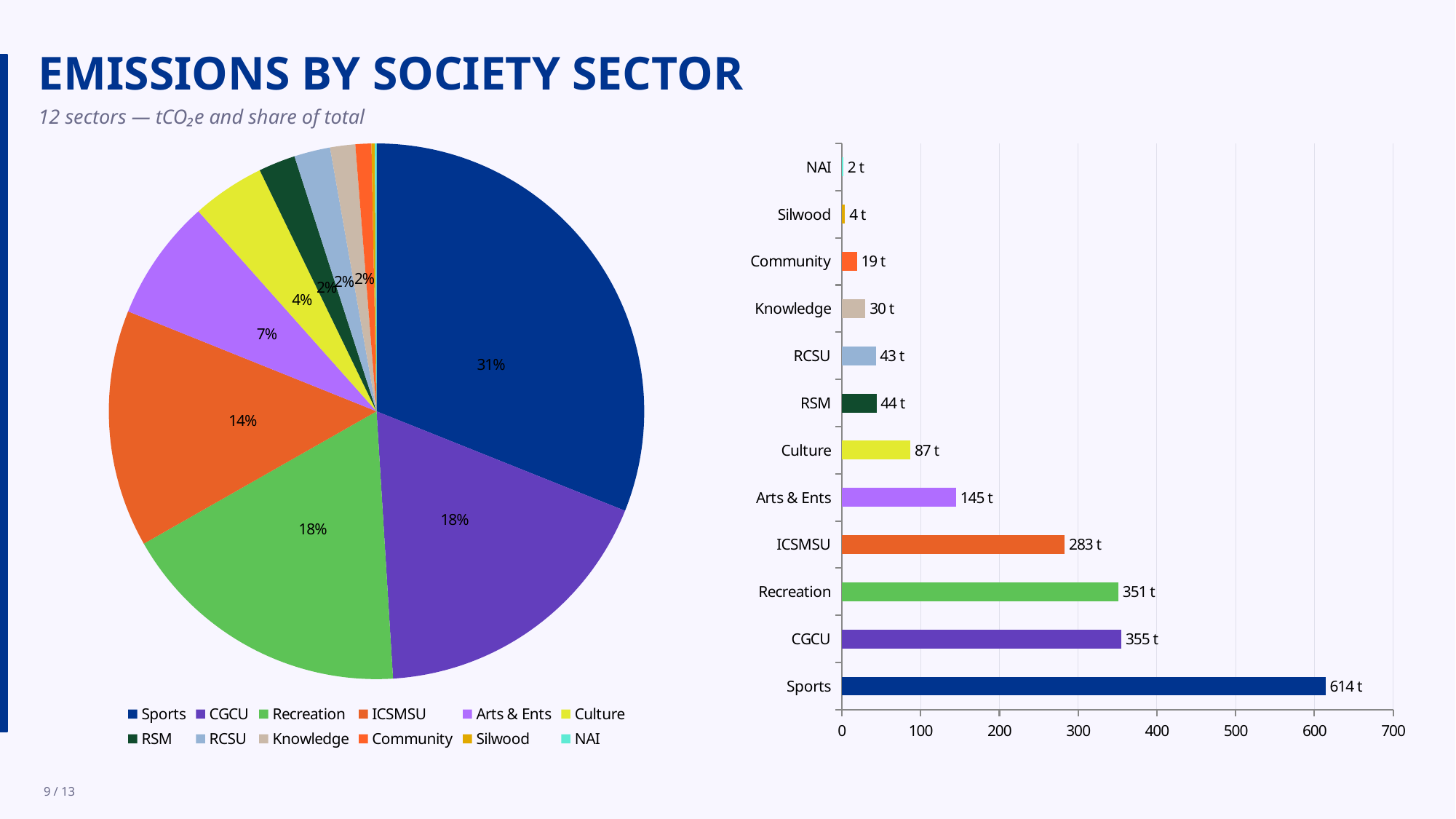
In the bar chart on the right, which sector has the highest emissions? Sports How many entries does the legend of the pie chart on the left list? 12 In the bar chart on the right, what is the difference between the values for Sports and CGCU? 259 t In the bar chart on the right, what is the value for Knowledge? 30 t In the bar chart on the right, which is larger, the value for ICSMSU or the value for Culture? ICSMSU In the pie chart on the left, what share of the total does ICSMSU account for? 14% In the bar chart on the right, what is the value for Sports? 614 t In the bar chart on the right, what is the value for Arts & Ents? 145 t In the pie chart on the left, what share of the total does Sports account for? 31% What kind of chart is on the right side of the slide? Bar chart In the bar chart on the right, which sector has the lowest emissions? NAI How many sectors are shown in the bar chart on the right? 12